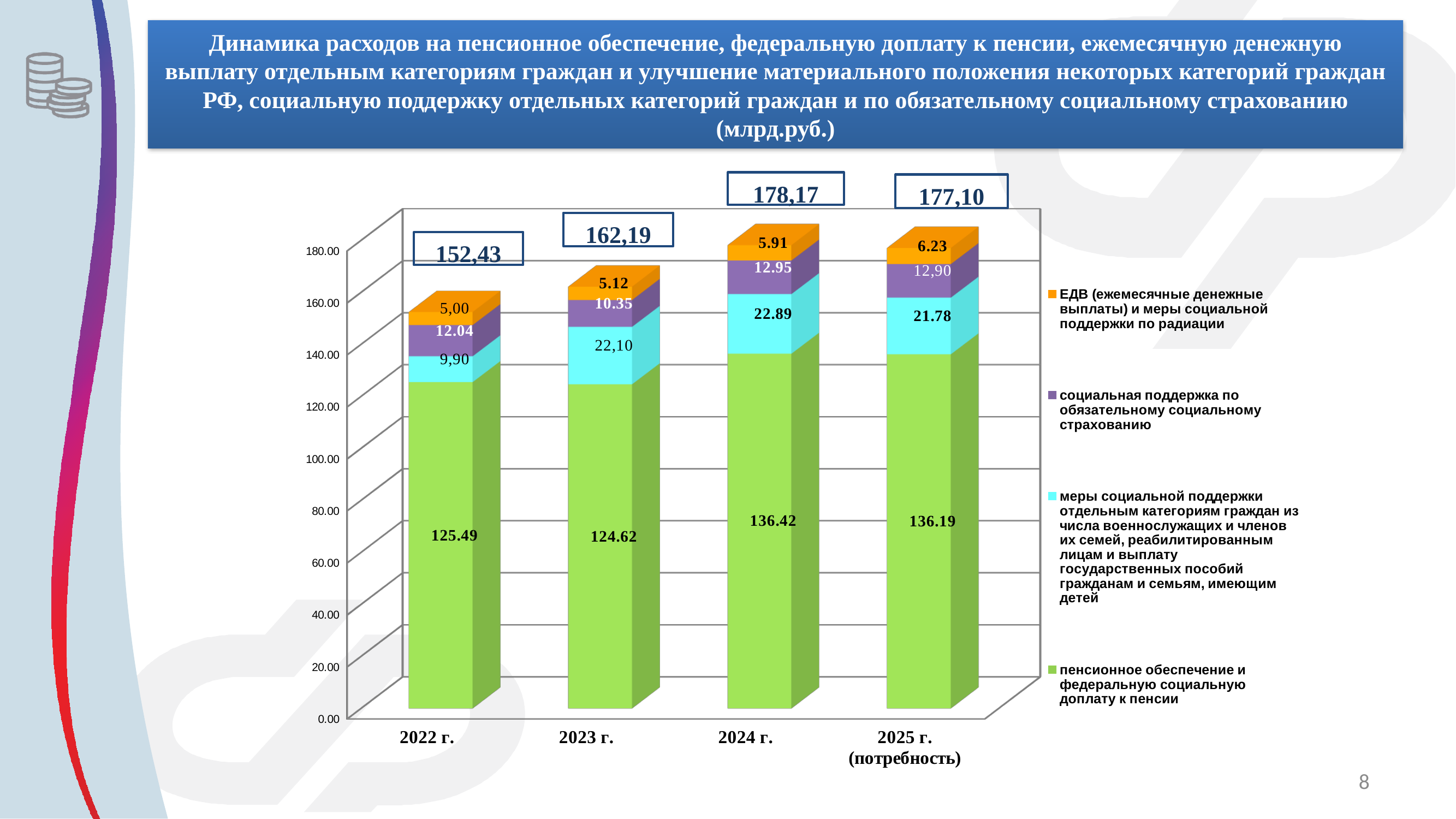
What is the value of the orange series (ЕДВ и меры социальной поддержки по радиации) for 2025 г. (потребность)? 6.23 What is the value of the green series (пенсионное обеспечение и федеральную социальную доплату к пенсии) for 2022 г.? 125.49 Which year has the highest total expenditure? 2024 г. What is the total shown above the stacked bar for 2022 г.? 152,43 What is the difference between the green series values for 2024 г. and 2023 г.? 11.80 How many series does the legend list? 4 Which is larger: the light-blue series value for 2022 г. or for 2023 г.? 2023 г. What is the total shown above the stacked bar for 2024 г.? 178,17 What is the value of the light-blue series (меры социальной поддержки отдельным категориям граждан...) for 2023 г.? 22,10 Which year has the lowest total expenditure? 2022 г. What kind of chart is shown on the slide? Stacked bar chart What is the value of the purple series (социальная поддержка по обязательному социальному страхованию) for 2024 г.? 12.95